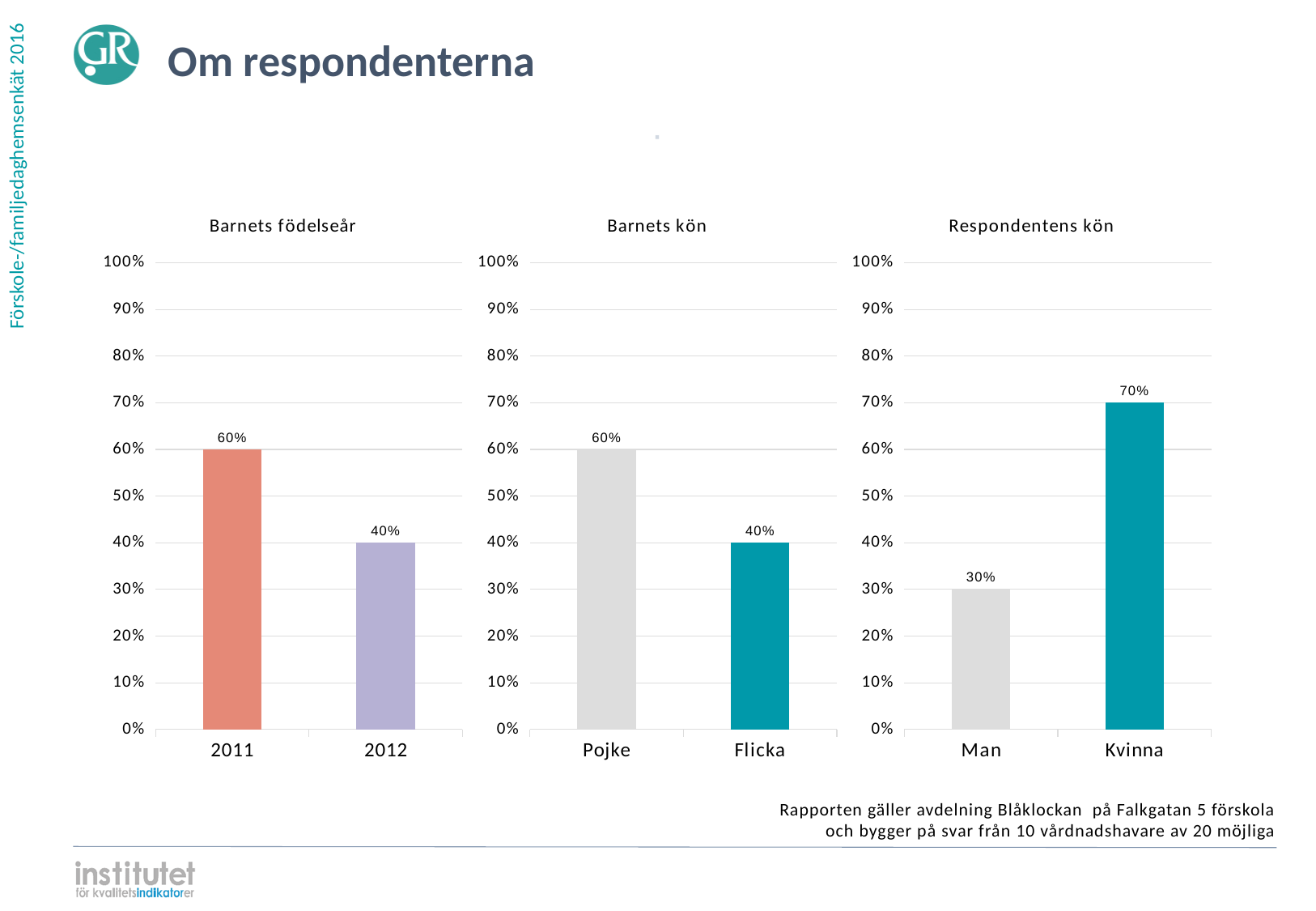
In the 'Respondentens kön' chart, what is the value for Man? 30% In the 'Respondentens kön' chart, what is the difference between the values for Kvinna and Man? 40% How many categories are shown in the 'Barnets kön' chart? 2 In the 'Barnets födelseår' chart, what is the value for 2012? 40% In the 'Barnets kön' chart, which is larger, the value for Pojke or the value for Flicka? Pojke In the 'Respondentens kön' chart, what is the value for Kvinna? 70% In the 'Barnets födelseår' chart, which category has the lowest value? 2012 In the 'Respondentens kön' chart, which category has the highest value? Kvinna In the 'Barnets födelseår' chart, what is the value for 2011? 60% In the 'Barnets kön' chart, what is the value for Pojke? 60% What kind of chart is the 'Respondentens kön' chart? Bar chart In the 'Barnets kön' chart, what is the value for Flicka? 40%